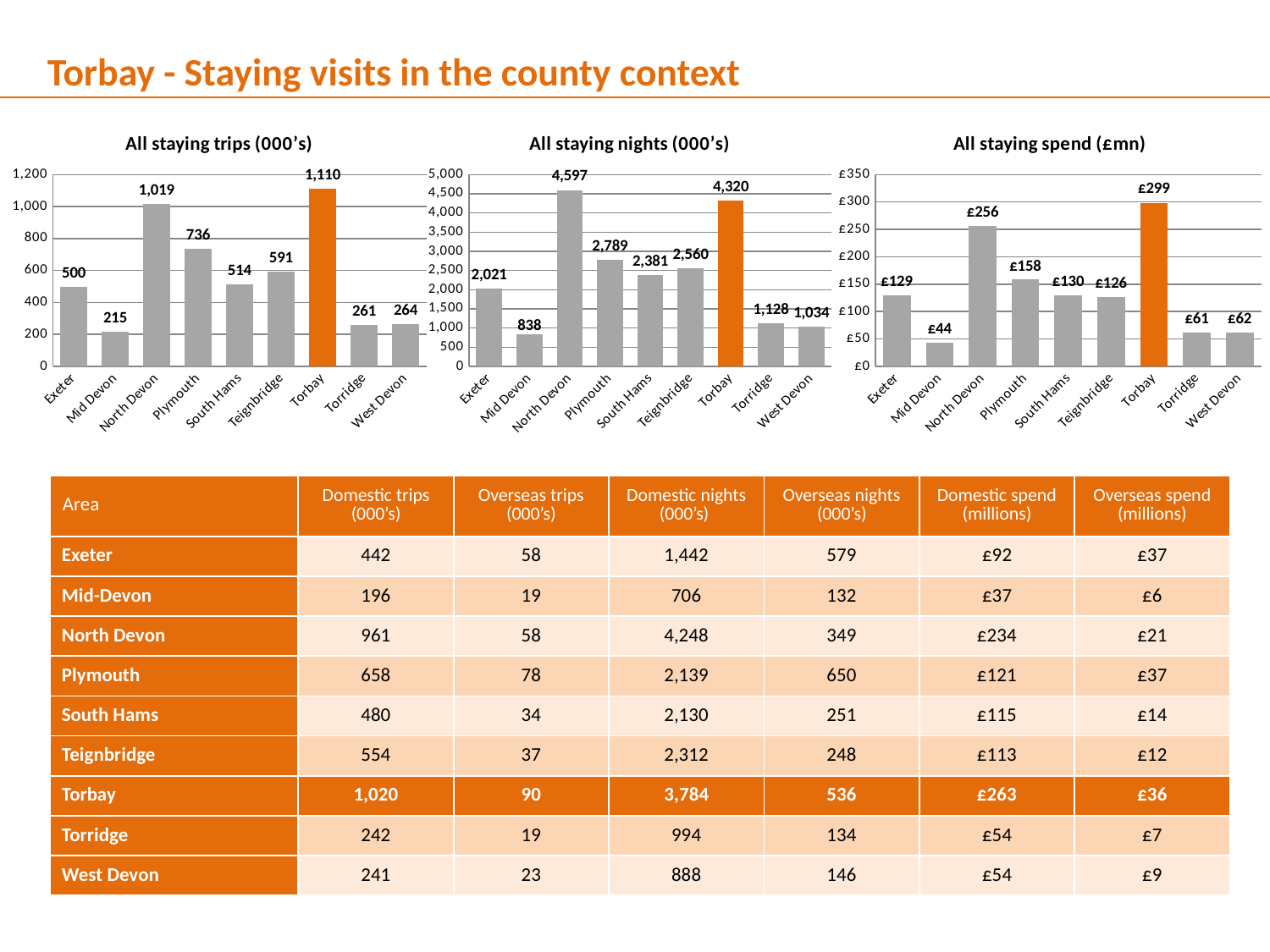
In the 'All staying spend (£mn)' chart, what is the value for North Devon? £256 In the 'All staying spend (£mn)' chart, which area has the highest value? Torbay In the 'All staying spend (£mn)' chart, what is the difference between Torbay and Mid Devon? £255 In the 'All staying nights (000's)' chart, which area has the highest value? North Devon In the 'All staying trips (000's)' chart, which area has the lowest value? Mid Devon In the 'All staying trips (000's)' chart, what is the value for Torbay? 1,110 In the 'All staying nights (000's)' chart, what is the value for Plymouth? 2,789 In the 'All staying spend (£mn)' chart, which area's bar is highlighted in orange? Torbay What type of chart is the 'All staying nights (000's)' chart? Bar chart In the 'All staying trips (000's)' chart, what is the difference between Torbay and North Devon? 91 How many areas are shown in the 'All staying trips (000's)' chart? 9 In the 'All staying nights (000's)' chart, which is larger, Torridge or West Devon? Torridge